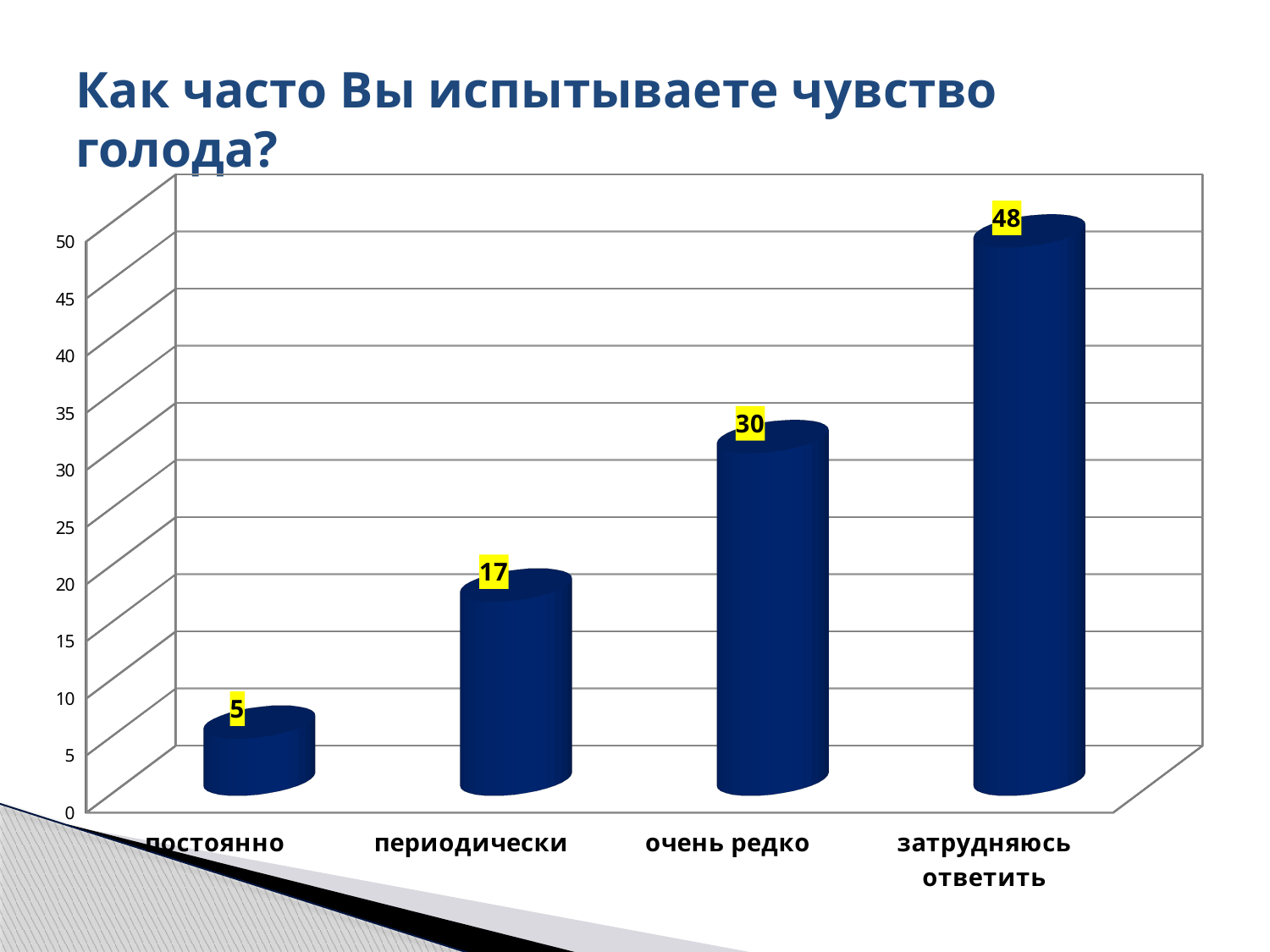
What kind of chart is shown on the slide? bar chart What is the value for "очень редко"? 30 Do the values rise or fall from left to right along the x axis? rise Which is larger, the value for "очень редко" or the value for "периодически"? очень редко What is the difference between the values for "затрудняюсь ответить" and "очень редко"? 18 What is the value for "периодически"? 17 What is the value for "постоянно"? 5 Which category has the lowest value? постоянно What is the value for "затрудняюсь ответить"? 48 Which category has the highest value? затрудняюсь ответить How many categories are shown on the x axis? 4 What is the difference between the values for "периодически" and "постоянно"? 12